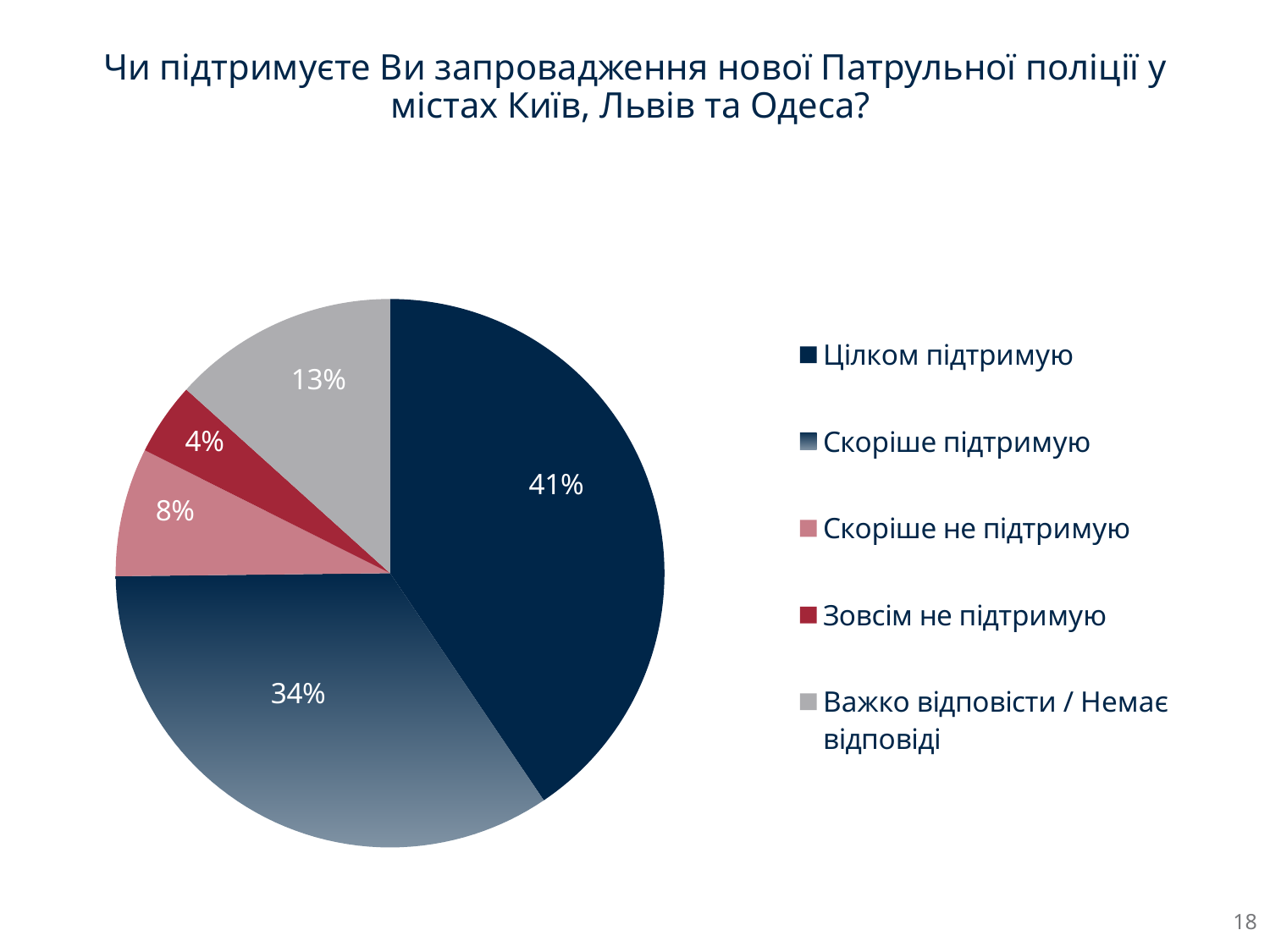
What share of respondents answered "Скоріше не підтримую"? 8% What is the difference in percentage points between "Цілком підтримую" and "Скоріше підтримую"? 7 What share of respondents answered "Скоріше підтримую"? 34% What is the combined share of "Цілком підтримую" and "Скоріше підтримую"? 75% Which answer option has the smallest share of the pie? Зовсім не підтримую What share of respondents answered "Цілком підтримую"? 41% Which answer option has the largest share of the pie? Цілком підтримую What share of respondents answered "Зовсім не підтримую"? 4% How many answer options are shown in the pie chart? 5 Which is larger: the share for "Скоріше не підтримую" or for "Важко відповісти / Немає відповіді"? Важко відповісти / Немає відповіді What share of respondents answered "Важко відповісти / Немає відповіді"? 13% What type of chart is shown on the slide? pie chart